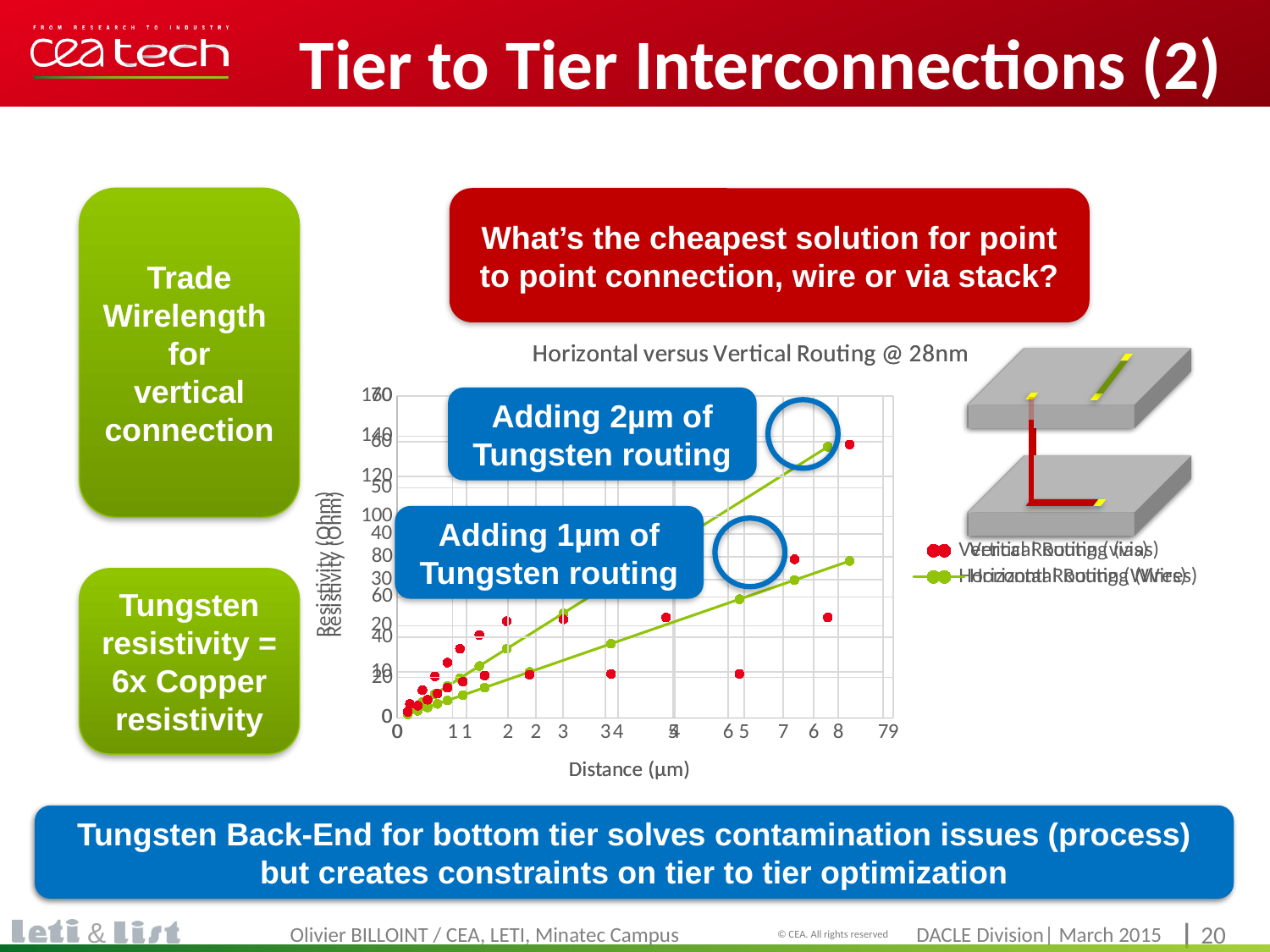
What is the label of the chart's x axis? Distance (µm) What kind of chart is shown on the slide? scatter chart What is the title of the chart on the slide? Horizontal versus Vertical Routing @ 28nm How many series does the chart's legend list? 2 Do the resistivity values for Vertical Routing (vias) generally rise or fall as distance increases along the x axis? rise Do the resistivity values for Horizontal Routing (Wires) rise or fall as distance increases along the x axis? rise